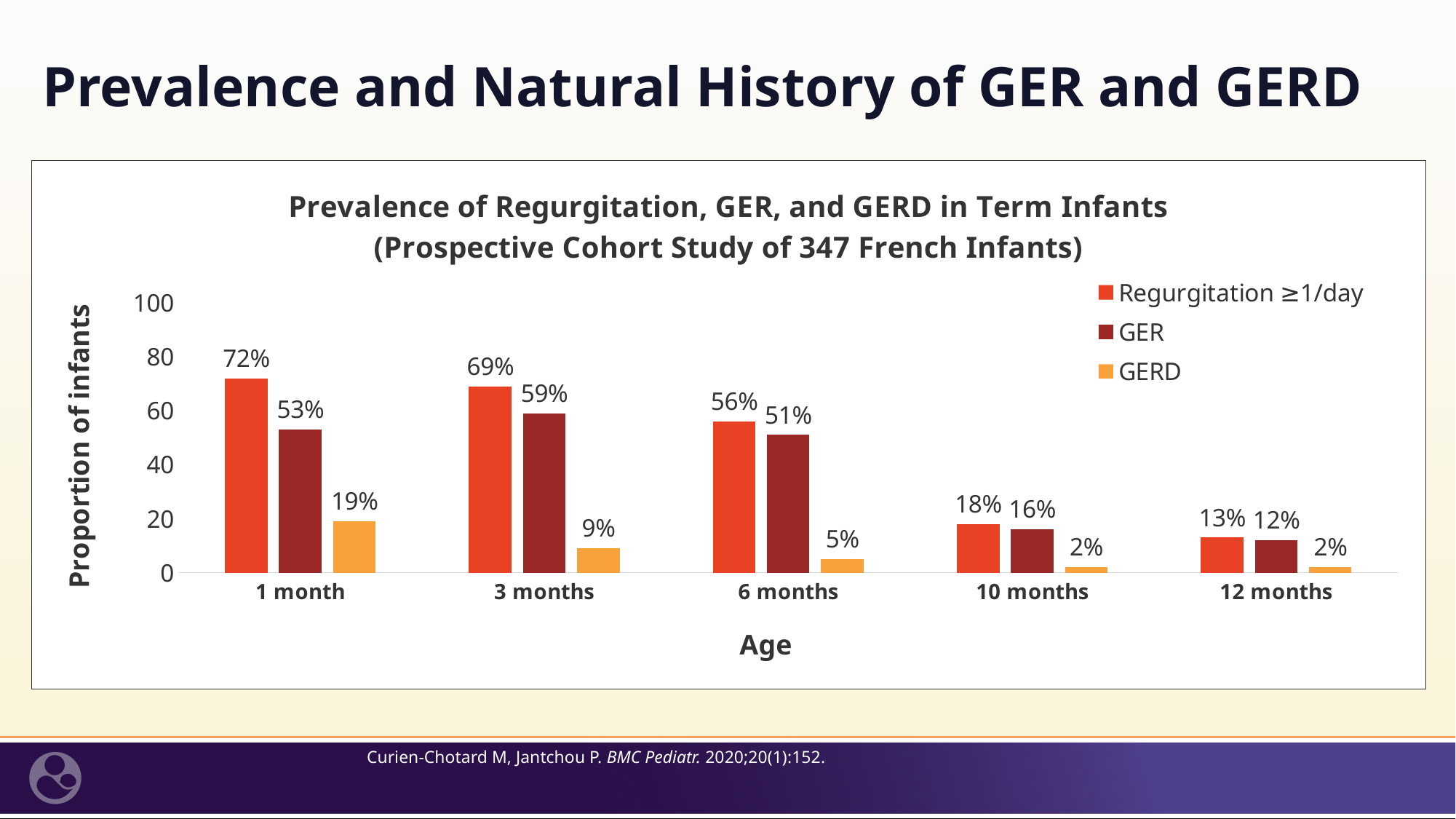
What is the label of the y axis? Proportion of infants How many series does the legend list? 3 What is the difference between the Regurgitation ≥1/day and GER values at 1 month? 19% At which age is the GERD value highest? 1 month What is the value for Regurgitation ≥1/day at 1 month? 72% At which age is the Regurgitation ≥1/day value lowest? 12 months How many age categories are shown on the x axis? 5 What kind of chart is shown? Bar chart Which is larger at 10 months: Regurgitation ≥1/day or GER? Regurgitation ≥1/day Do the GER values rise or fall as age increases from 1 month to 12 months? Fall What is the value for GERD at 3 months? 9% What is the value for GER at 6 months? 51%